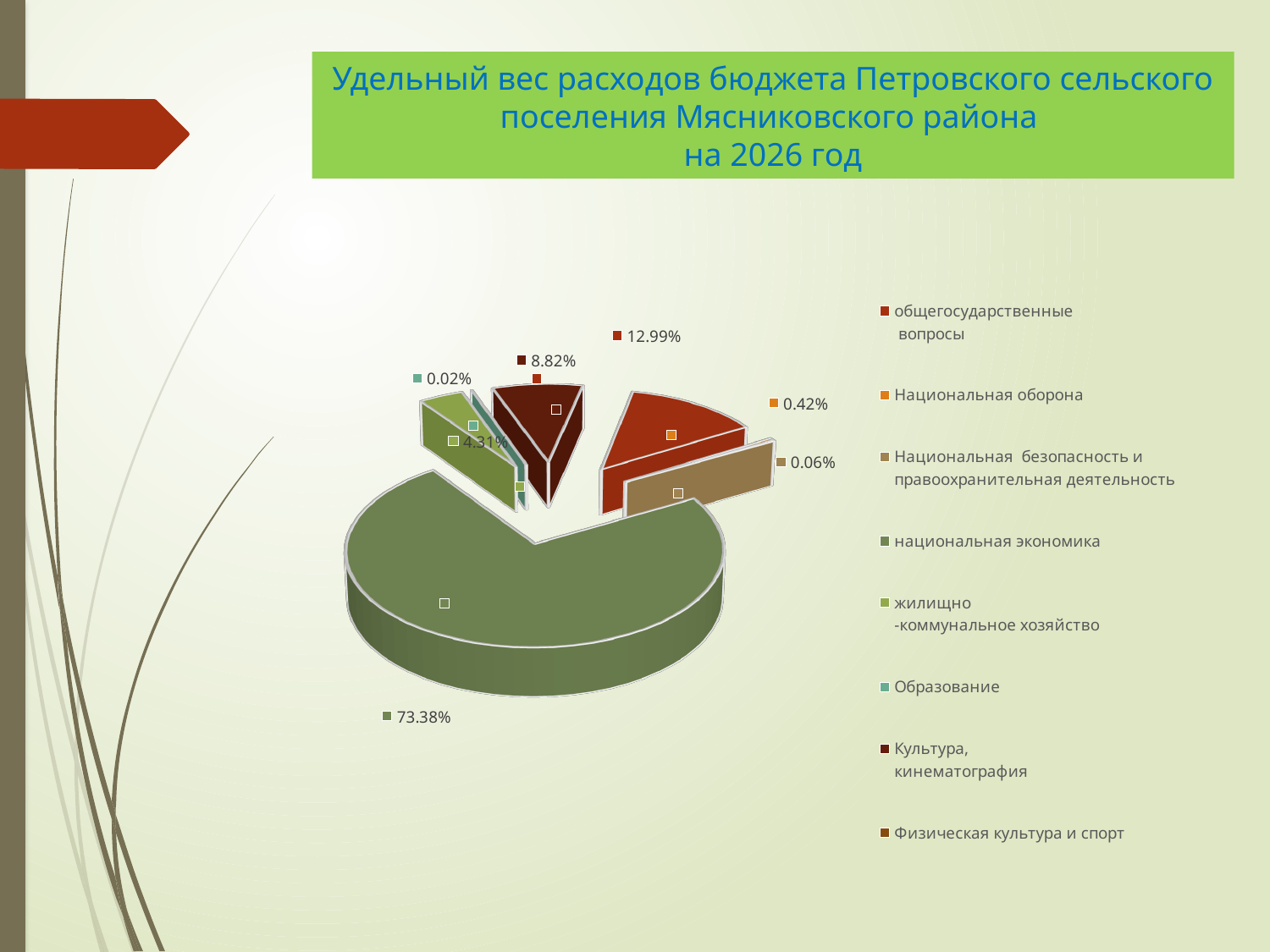
Which is larger: the share for Национальная оборона or the share for Национальная безопасность и правоохранительная деятельность? Национальная оборона What is the value shown for Национальная оборона? 0.42% What is the value shown for Образование? 0.02% What is the value shown for Культура, кинематография? 8.82% For which year does the chart title say the budget expenditure shares are given? 2026 How many entries does the legend of the pie chart list? 8 What is the value shown for общегосударственные вопросы? 12.99% What kind of chart is shown on the slide? pie chart What is the difference between the shares of общегосударственные вопросы and Культура, кинематография? 4.17% What share of the pie does национальная экономика have? 73.38% Which category has the largest share of the pie? национальная экономика What is the value shown for жилищно-коммунальное хозяйство? 4.31%